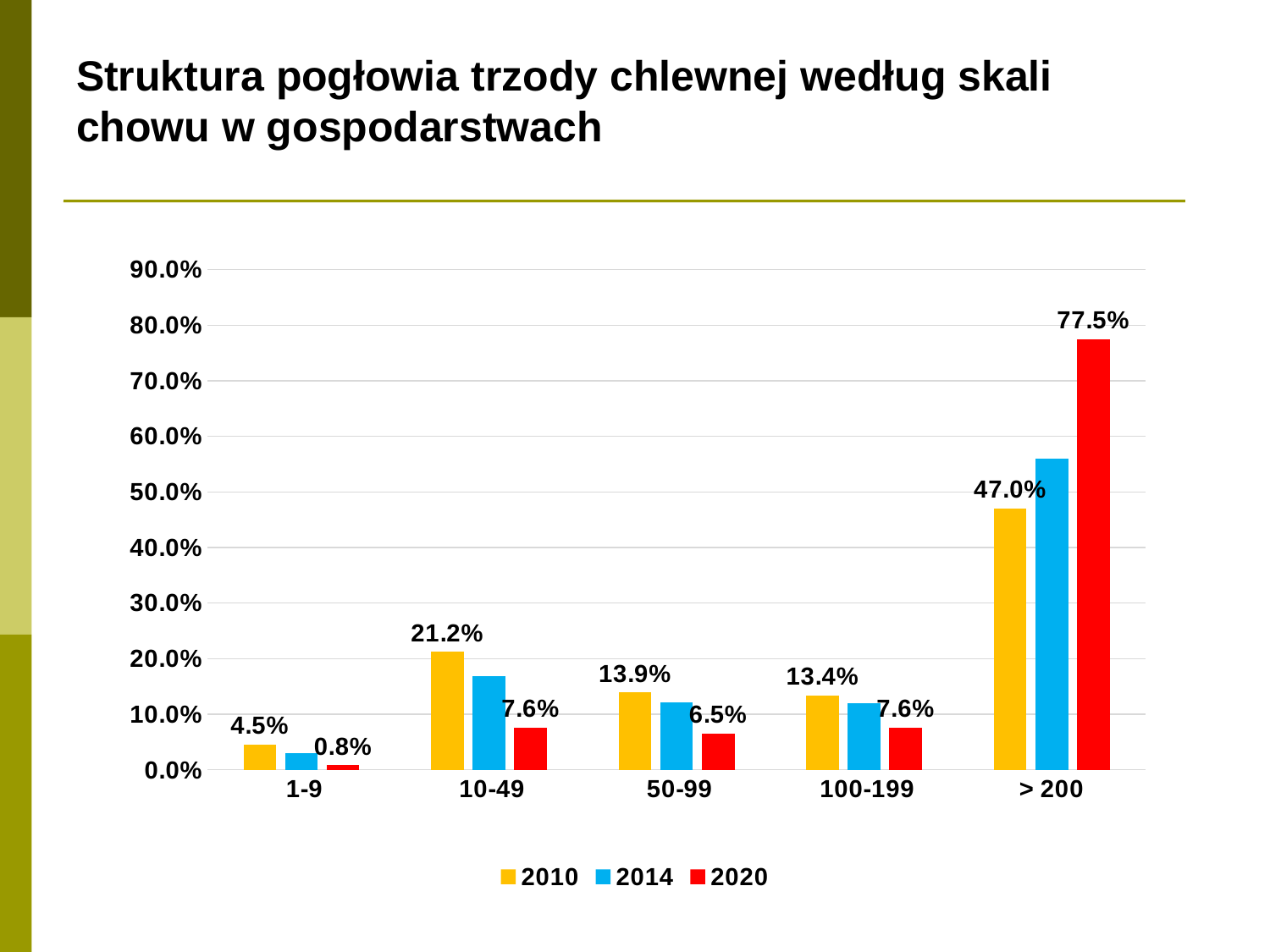
What kind of chart is shown on the slide? bar chart What is the value for the 2020 series in the 50-99 category? 6.5% What is the difference between the 2020 and 2010 values in the > 200 category? 30.5% Which category has the highest value for the 2020 series? > 200 How many series does the legend list? 3 Which is larger in the 10-49 category: the 2010 value or the 2020 value? 2010 How many categories are shown on the x axis? 5 What is the value for the 2010 series in the 10-49 category? 21.2% Is the value for the 2014 series in the > 200 category greater or less than 50.0%? greater What is the value for the 2010 series in the 1-9 category? 4.5% Which category has the lowest value for the 2010 series? 1-9 What is the value for the 2020 series in the > 200 category? 77.5%